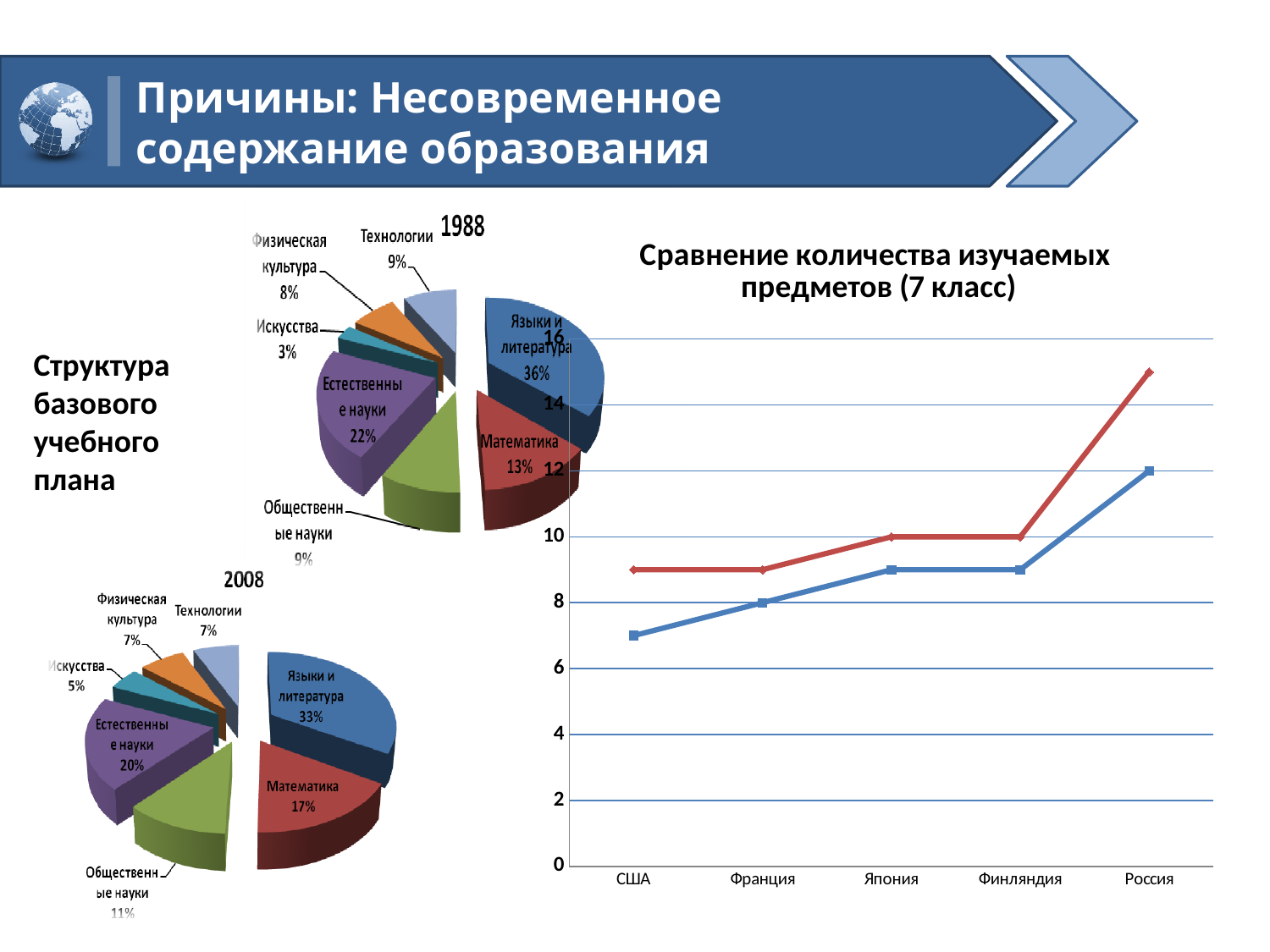
In the chart 'Сравнение количества изучаемых предметов (7 класс)', is the value of the red line for Россия greater or less than 14? greater In the 2008 pie chart, what share is Математика? 17% In the 2008 pie chart, which category has the largest share? Языки и литература In the chart 'Сравнение количества изучаемых предметов (7 класс)', what is the value of the blue line for Франция? 8 In the 1988 pie chart, which category has the smallest share? Искусства How many categories does the 2008 pie chart show? 7 In the 1988 pie chart, what share is Языки и литература? 36% In the 2008 pie chart, what is the difference between the shares of Естественные науки and Общественные науки? 9% In the 1988 pie chart, which is larger: Естественные науки or Математика? Естественные науки In the chart 'Сравнение количества изучаемых предметов (7 класс)', what is the value of the red line for Япония? 10 What kind of chart is 'Сравнение количества изучаемых предметов (7 класс)'? line chart In the chart 'Сравнение количества изучаемых предметов (7 класс)', which country has the highest value on the blue line? Россия